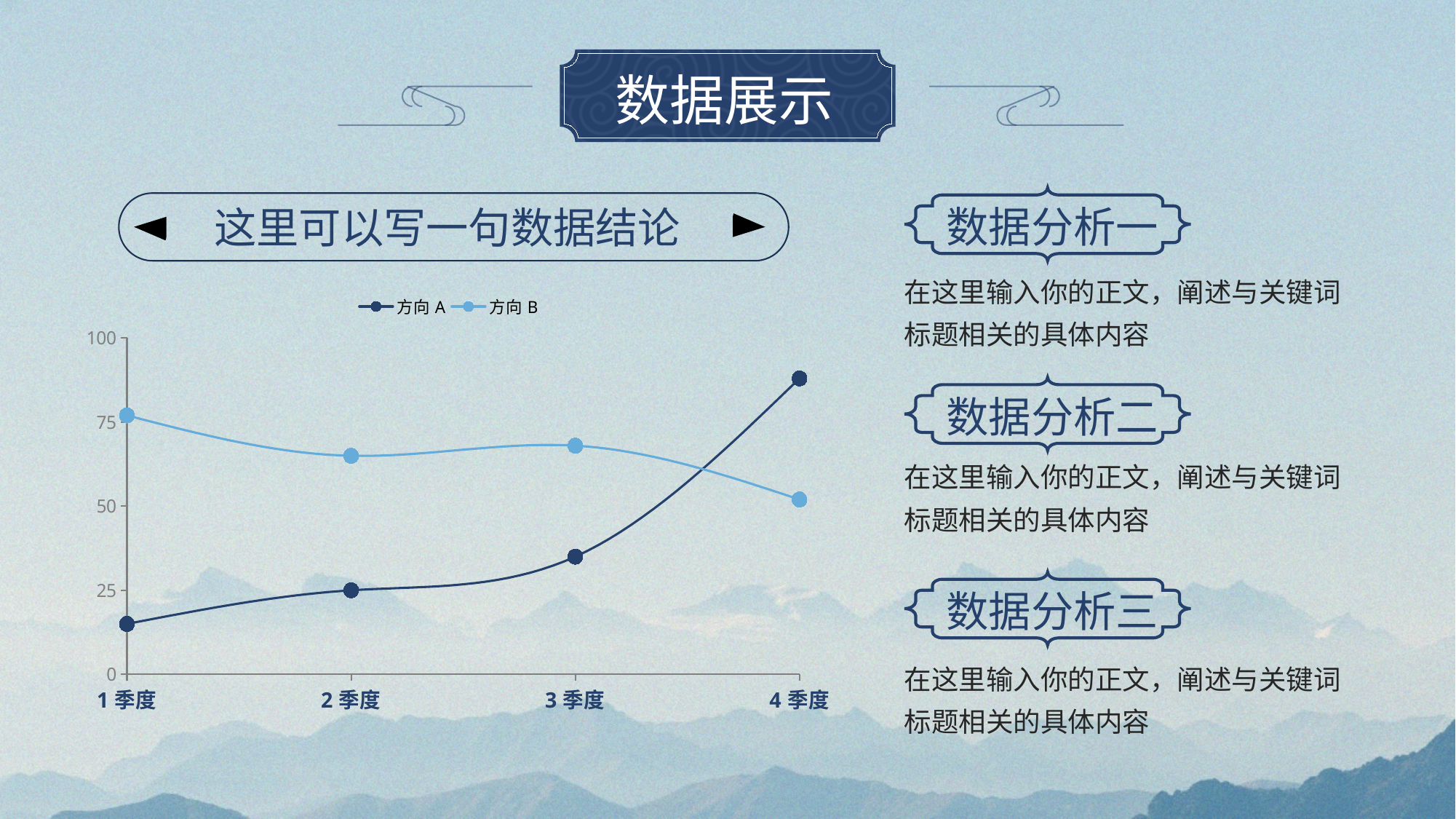
In which quarter is the value for 方向 B highest? 1 季度 Do the values for 方向 A rise or fall from 1 季度 to 4 季度? rise At 4 季度, which series has the larger value, 方向 A or 方向 B? 方向 A At 1 季度, which series has the larger value, 方向 A or 方向 B? 方向 B What kind of chart is shown on the slide? line chart In which quarter is the value for 方向 A lowest? 1 季度 How many categories are shown on the x axis of the chart? 4 In which quarter is the value for 方向 B lowest? 4 季度 What are the two series named in the chart legend? 方向 A and 方向 B In which quarter is the value for 方向 A highest? 4 季度 How many series does the chart legend list? 2 Is the value for 方向 A at 4 季度 greater or less than 75? greater